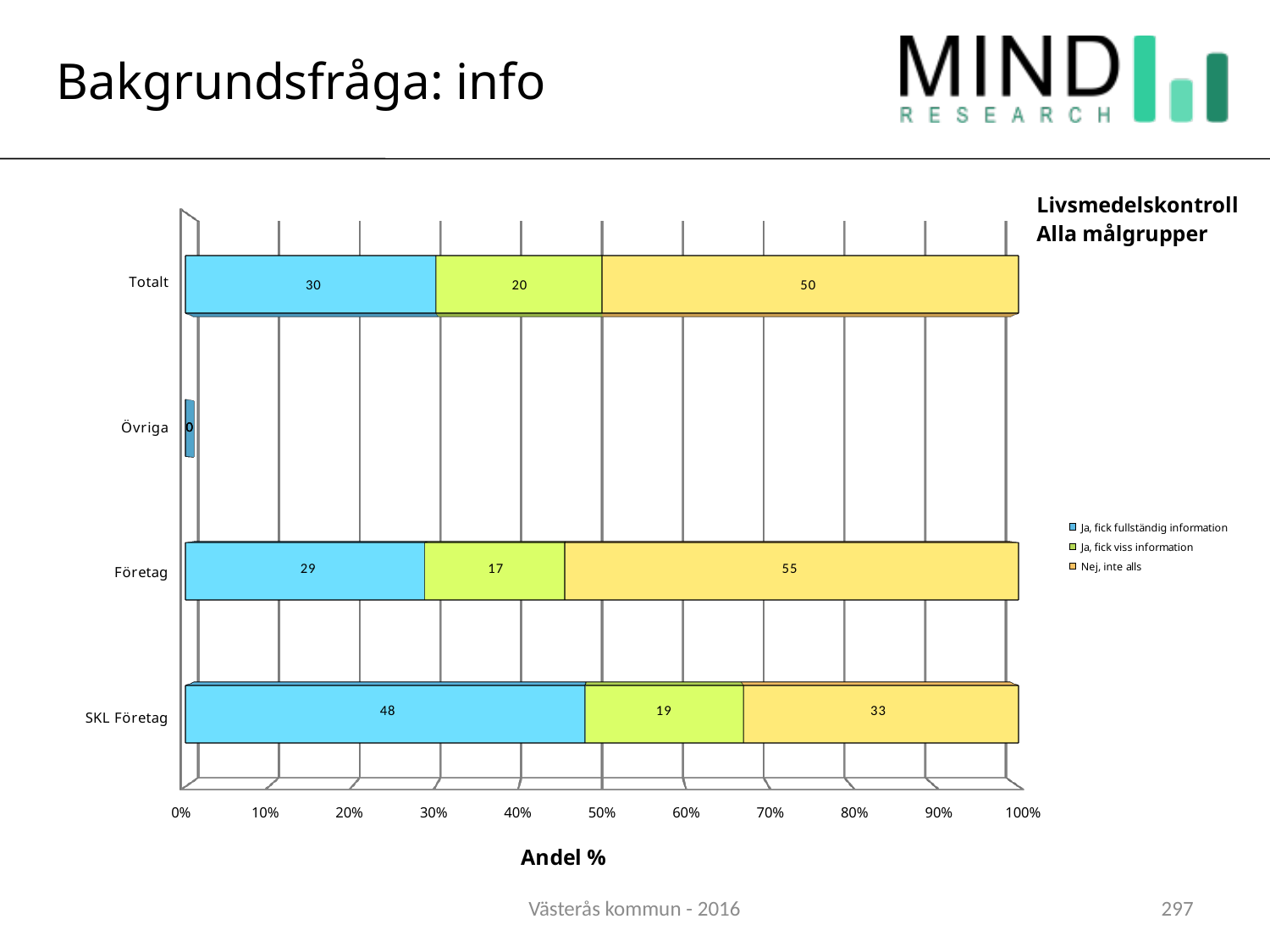
Which category has the highest value for "Ja, fick fullständig information"? SKL Företag Which is larger: the "Ja, fick viss information" value for Totalt or for Företag? Totalt What is the value of "Nej, inte alls" for Företag? 55 What is the x-axis title of the chart? Andel % How many series does the legend list? 3 Which category has the lowest value for "Nej, inte alls" among those with a printed value? SKL Företag What is the difference between the "Nej, inte alls" values for Företag and SKL Företag? 22 What is the value of "Ja, fick fullständig information" for Totalt? 30 How many categories are shown on the vertical axis? 4 What is the total of the stacked bar for Totalt? 100 What is the value of "Ja, fick viss information" for SKL Företag? 19 What kind of chart is shown on the slide? Stacked bar chart